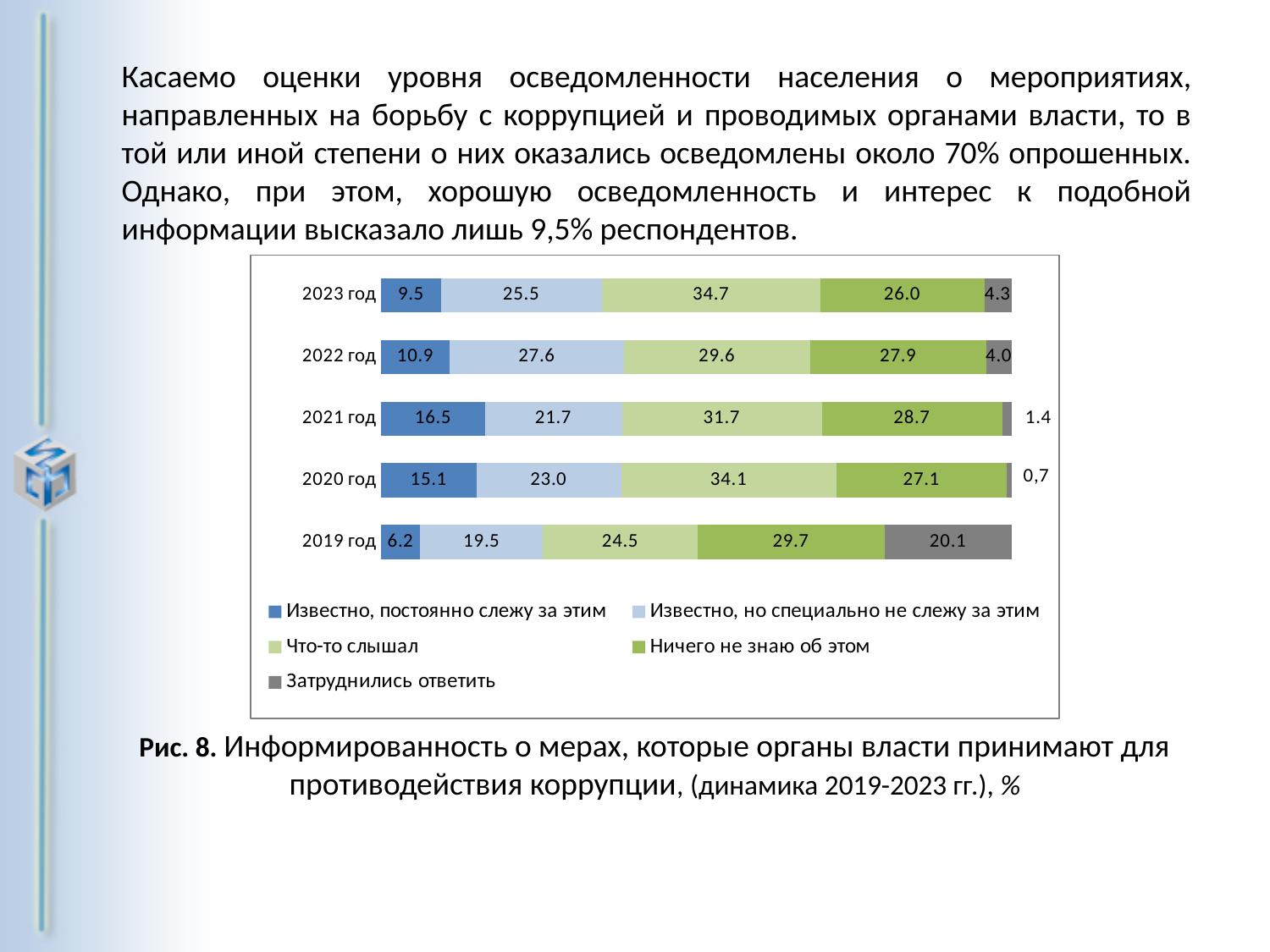
Which year has the highest value for "Известно, постоянно слежу за этим"? 2021 год How many series does the legend list? 5 What is the value for "Затруднились ответить" in 2019 год? 20.1 From 2021 год to 2023 год, does the value for "Известно, постоянно слежу за этим" rise or fall? Fall What is the value for "Известно, постоянно слежу за этим" in 2023 год? 9.5 How many years (categories) are shown in the chart? 5 What is the total of the stacked bar for 2023 год? 100.0 Which year has the larger value for "Ничего не знаю об этом": 2020 год or 2021 год? 2021 год Which year has the lowest value for "Затруднились ответить"? 2020 год What is the difference between the "Что-то слышал" values for 2023 год and 2022 год? 5.1 What kind of chart is shown on the slide? Stacked bar chart What is the value for "Что-то слышал" in 2020 год? 34.1